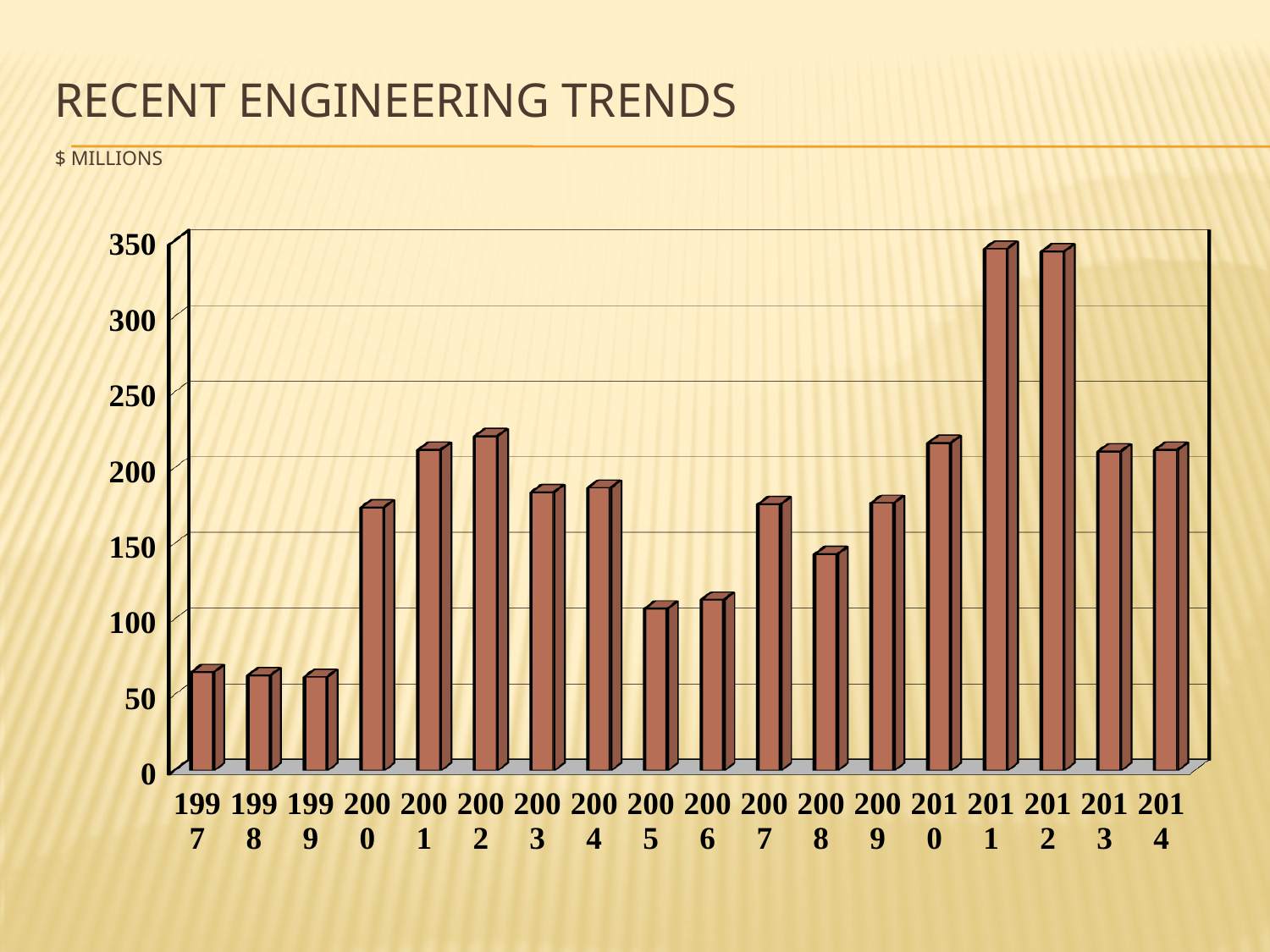
What is the title of the chart on the slide? RECENT ENGINEERING TRENDS Is the value for 2006 greater or less than 150? less What unit is stated for the values in the chart? $ MILLIONS Which year has the larger value, 1999 or 2000? 2000 Is the value for 1997 greater or less than 100? less What kind of chart is shown on the slide? bar chart Which year has the larger value, 2005 or 2011? 2011 Do the values rise or fall from 2002 to 2005? fall Is the value for 2011 greater or less than 300? greater How many years are plotted on the x axis of the chart? 18 Which year has the larger value, 2002 or 2003? 2002